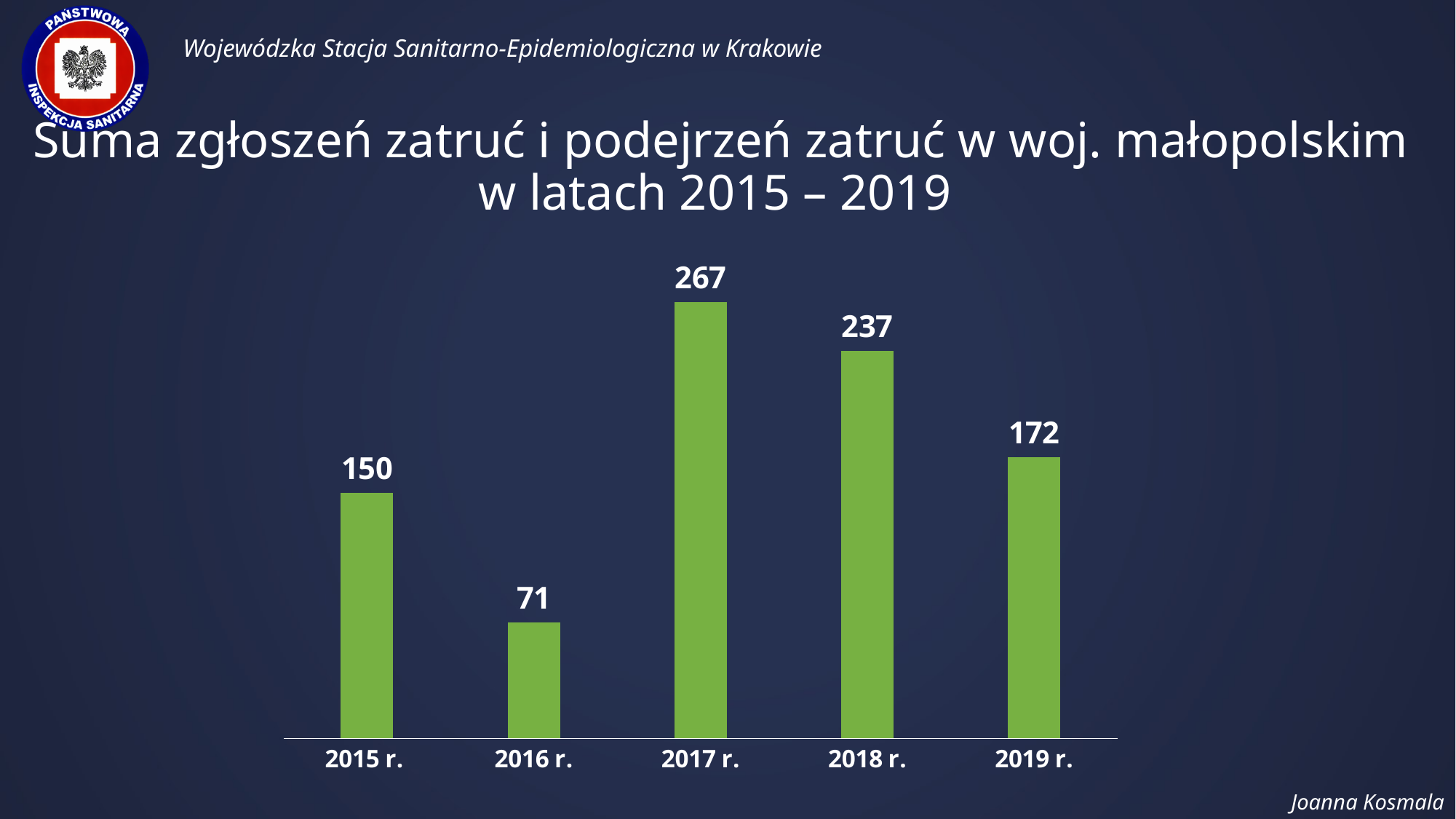
What kind of chart is shown on the slide? Bar chart Which is larger, the value for 2015 r. or the value for 2019 r.? 2019 r. What is the difference between the values for 2017 r. and 2018 r.? 30 How many years are shown on the chart? 5 What is the value for 2017 r.? 267 What is the value for 2018 r.? 237 What is the value for 2019 r.? 172 Which year has the highest value? 2017 r. What is the value for 2016 r.? 71 Do the values rise or fall from 2017 r. to 2019 r.? Fall Which year has the lowest value? 2016 r. What is the value for 2015 r.? 150